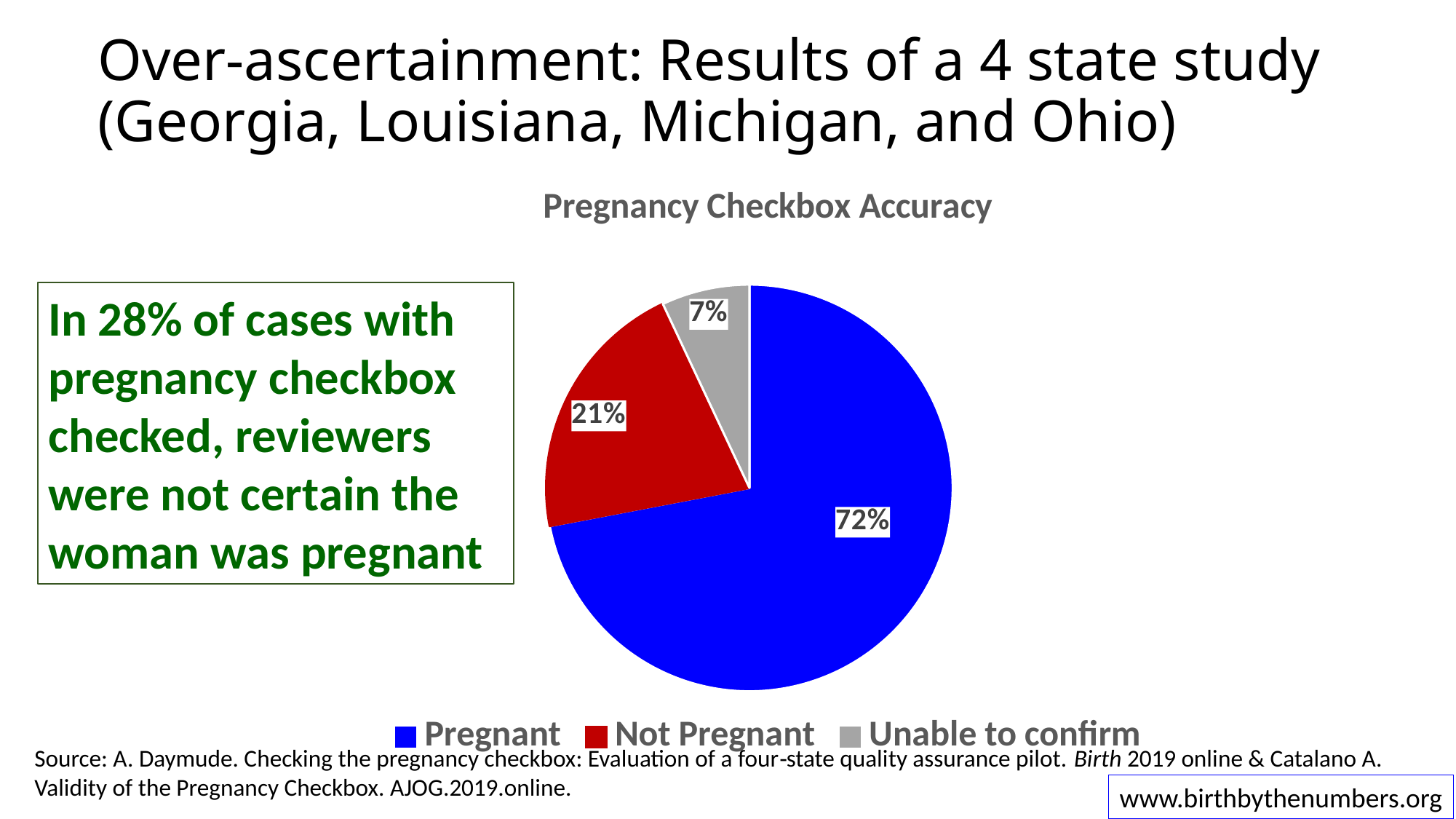
How many slices does the pie chart have? 3 Which category has the largest slice of the pie? Pregnant What is the title of the chart? Pregnancy Checkbox Accuracy What is the difference in percentage points between the Not Pregnant and Unable to confirm slices? 14 Which category has the smallest slice of the pie? Unable to confirm What kind of chart is shown on the slide? Pie chart What colour is the Not Pregnant slice? Red What is the difference in percentage points between the Pregnant and Not Pregnant slices? 51 What share of the pie is labelled Not Pregnant? 21% Which slice is larger, Not Pregnant or Unable to confirm? Not Pregnant What share of the pie is labelled Pregnant? 72% What share of the pie is labelled Unable to confirm? 7%